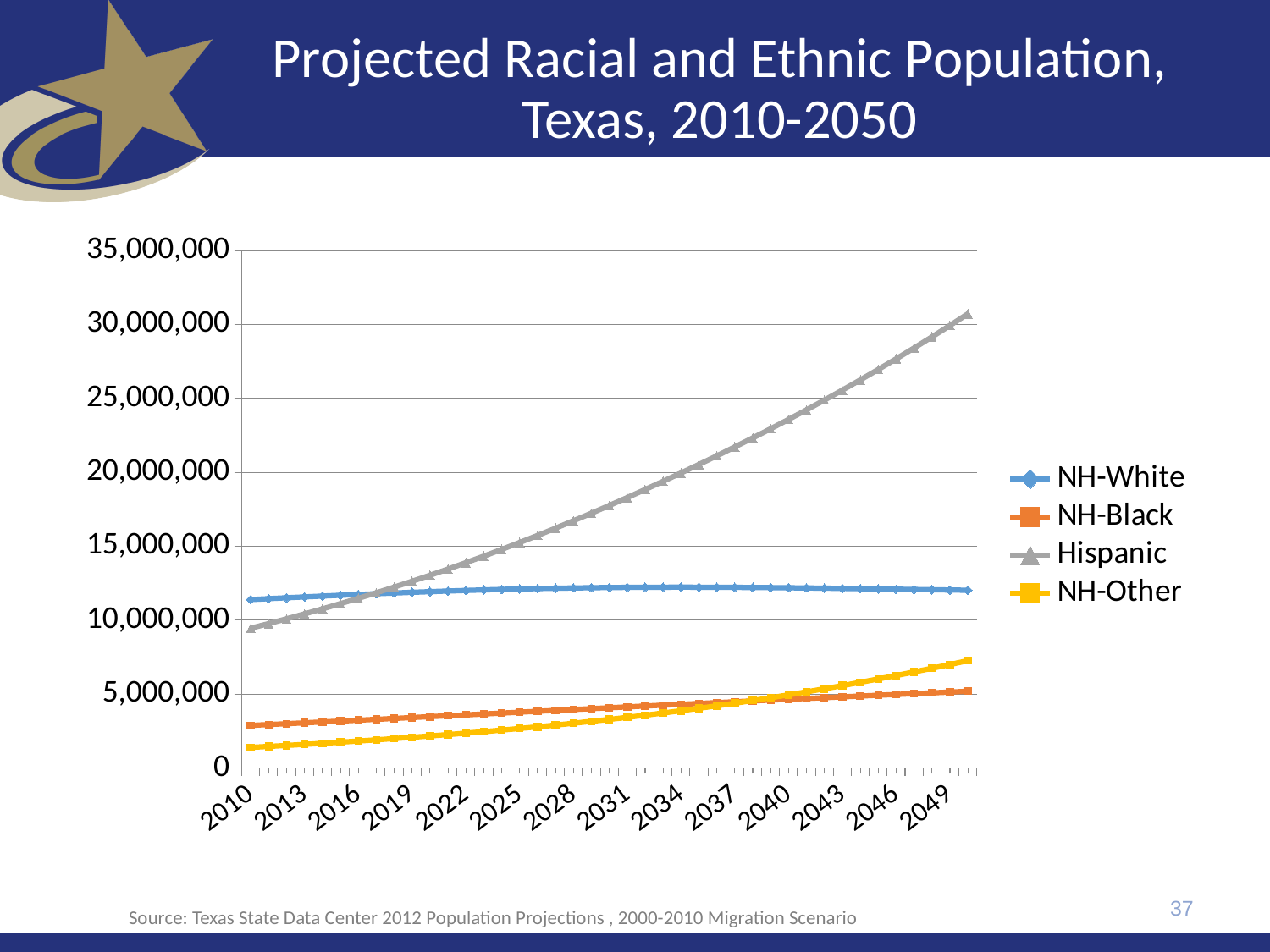
Does the Hispanic series rise or fall from 2010 to 2050? rise Is the value for Hispanic in 2050 greater or less than 30,000,000? greater What is the title of the chart on the slide? Projected Racial and Ethnic Population, Texas, 2010-2050 Which series has the highest value in 2050? Hispanic How many series does the legend list? 4 Which series has the highest value in 2010? NH-White Is the value for Hispanic in 2010 greater or less than 10,000,000? less Which series has the lowest value in 2010? NH-Other Is the value for NH-White in 2010 greater or less than 10,000,000? greater Does the NH-Other series rise or fall from 2010 to 2050? rise What kind of chart is shown on the slide? line chart In 2050, which is larger: NH-Other or NH-Black? NH-Other